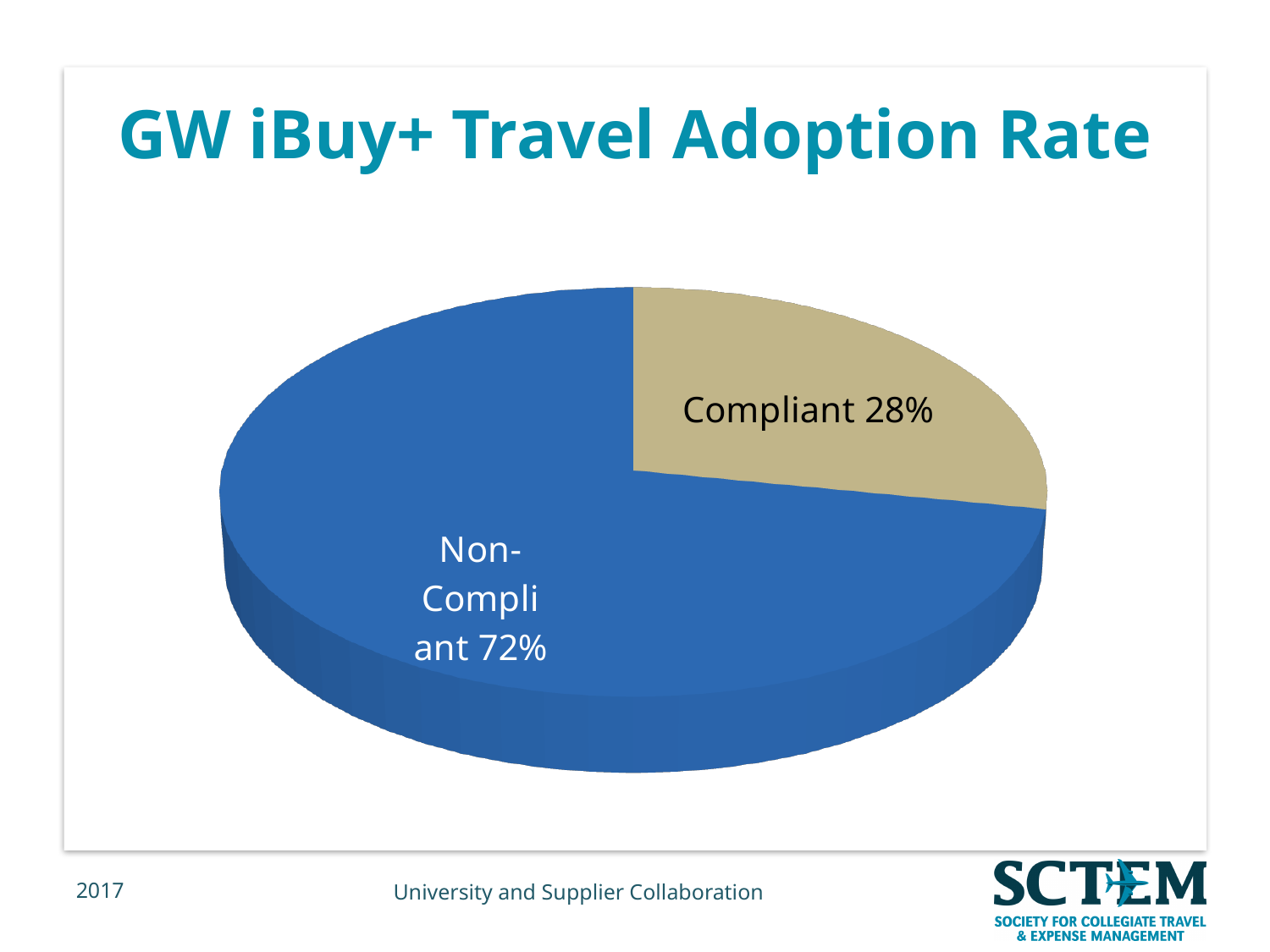
Which slice of the pie is the largest? Non-Compliant How many slices does the pie chart have? 2 What share of the pie is labelled Compliant? 28% What do the two slices of the pie add up to? 100% What colour is the Non-Compliant slice of the pie? Blue What is the difference in percentage points between the Non-Compliant and Compliant slices? 44 What share of the pie is labelled Non-Compliant? 72% What kind of chart is shown on the slide? Pie chart Is the Compliant share greater or less than 50%? less What is the title of the chart on the slide? GW iBuy+ Travel Adoption Rate Which is larger, the Compliant slice or the Non-Compliant slice? Non-Compliant Which slice of the pie is the smallest? Compliant